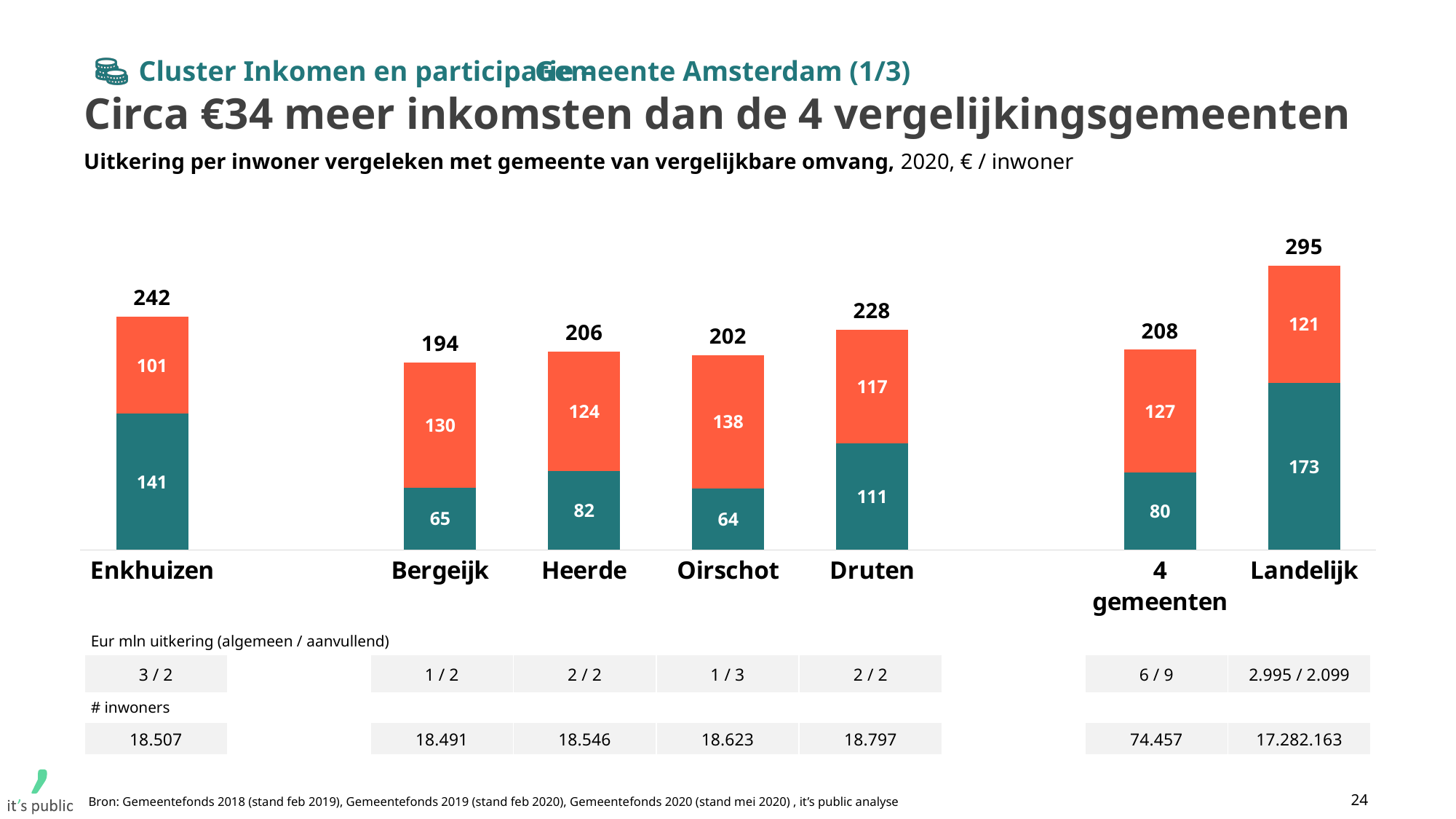
What is the value of the teal (bottom) segment for Druten? 111 What is the total value printed above the bar for Enkhuizen? 242 What is the value of the teal (bottom) segment for Landelijk? 173 What is the difference between the total for Landelijk and the total for 4 gemeenten? 87 What is the difference between the teal (bottom) segment for Enkhuizen and the teal (bottom) segment for Oirschot? 77 Which has a larger total, Druten or Heerde? Druten Which category has the highest total value? Landelijk What kind of chart is shown on the slide? Stacked bar chart What is the value of the orange (top) segment for Oirschot? 138 Which category has the lowest total value? Bergeijk What unit is stated in the chart subtitle for the values? € / inwoner How many categories are shown on the x axis? 7